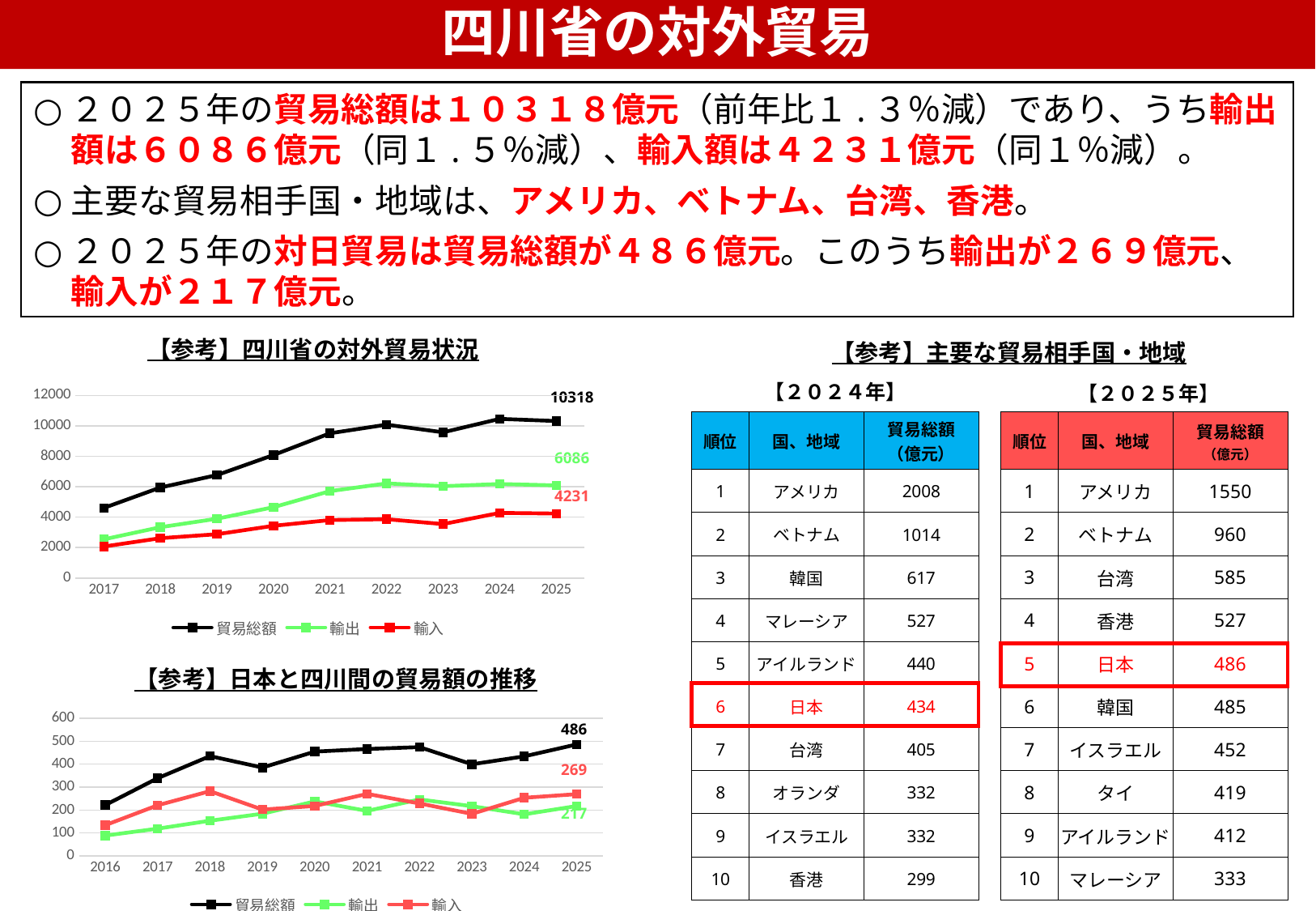
In the 【参考】日本と四川間の貿易額の推移 chart, is the value of 貿易総額 in 2016 greater or less than 300? less In the 【参考】四川省の対外貿易状況 chart, is the value of 貿易総額 in 2017 greater or less than 6000? less What kind of chart is the 【参考】四川省の対外貿易状況 chart? line chart In the 【参考】日本と四川間の貿易額の推移 chart, what is the value of 貿易総額 in 2025? 486 In the 【参考】四川省の対外貿易状況 chart, what is the difference between 輸出 and 輸入 in 2025? 1855 How many series does the legend of the 【参考】四川省の対外貿易状況 chart list? 3 In the 【参考】四川省の対外貿易状況 chart, does 貿易総額 rise or fall from 2017 to 2025? rise In the 【参考】四川省の対外貿易状況 chart, what is the value of 貿易総額 in 2025? 10318 How many years are plotted on the x axis of the 【参考】四川省の対外貿易状況 chart? 9 In the 【参考】日本と四川間の貿易額の推移 chart, which is larger in 2025, 輸出 or 輸入? 輸入 In the 【参考】日本と四川間の貿易額の推移 chart, what is the difference between 輸出 and 輸入 in 2025? 52 In the 【参考】四川省の対外貿易状況 chart, what is the value of 輸出 in 2025? 6086